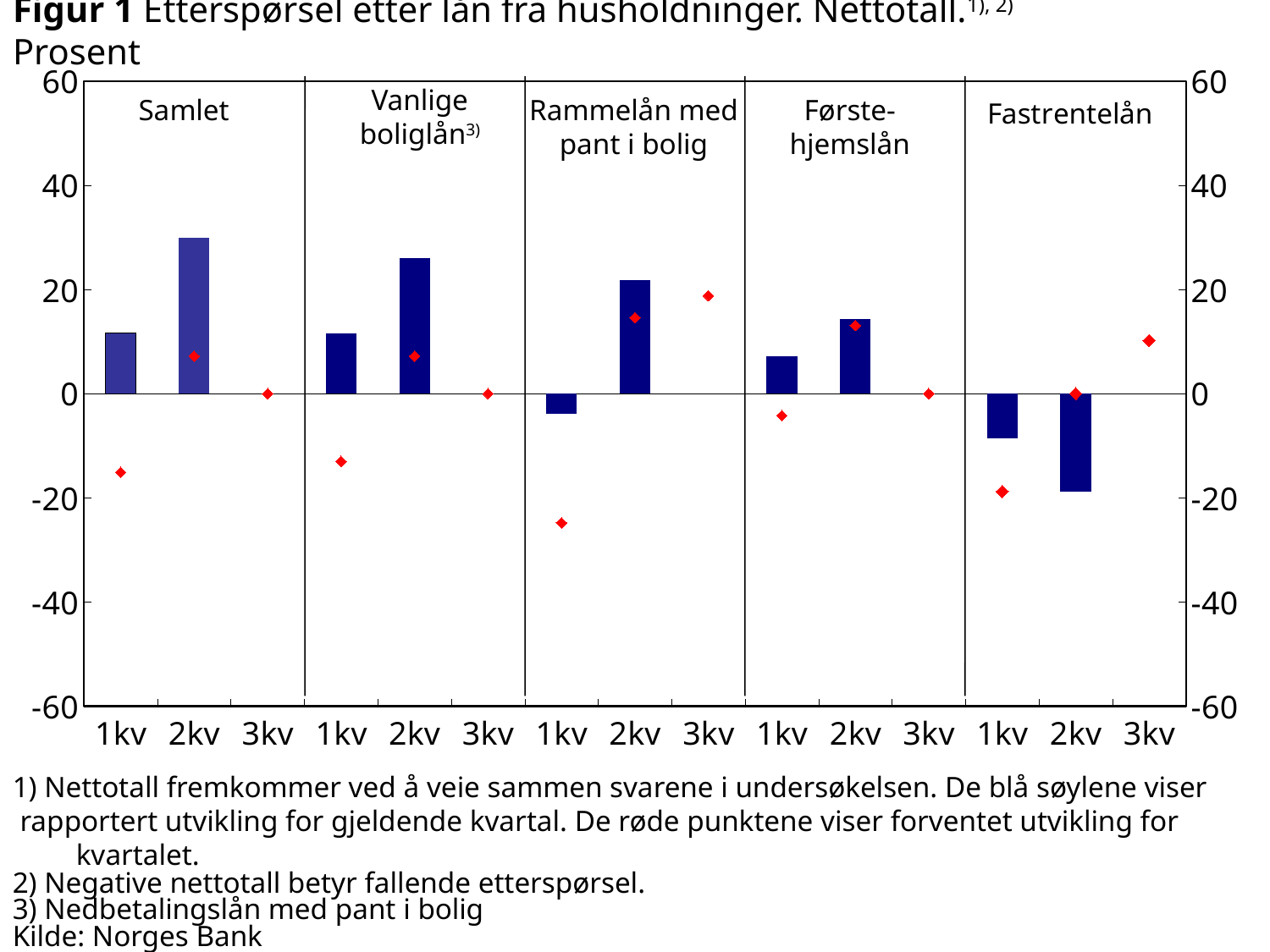
How many quarters are shown on the x axis within each panel? 3 Which is larger, the 2kv bar for Rammelån med pant i bolig or the 2kv bar for Førstehjemslån? Rammelån med pant i bolig Is the bar for Fastrentelån in 2kv greater or less than -10? less Which is larger, the 1kv bar for Samlet or the 1kv bar for Førstehjemslån? Samlet Is the bar for Vanlige boliglån in 2kv greater or less than 20? greater What kind of chart is shown on the slide? combination bar and point chart (blue bars with red point markers) According to the footnote, what is the source of the chart? Norges Bank Which loan category and quarter has the lowest bar in the chart? Fastrentelån, 2kv How many loan categories (panels) does the chart show? 5 Is the red point for Rammelån med pant i bolig in 1kv greater or less than -20? less Which loan category has the highest bar for 2kv? Samlet